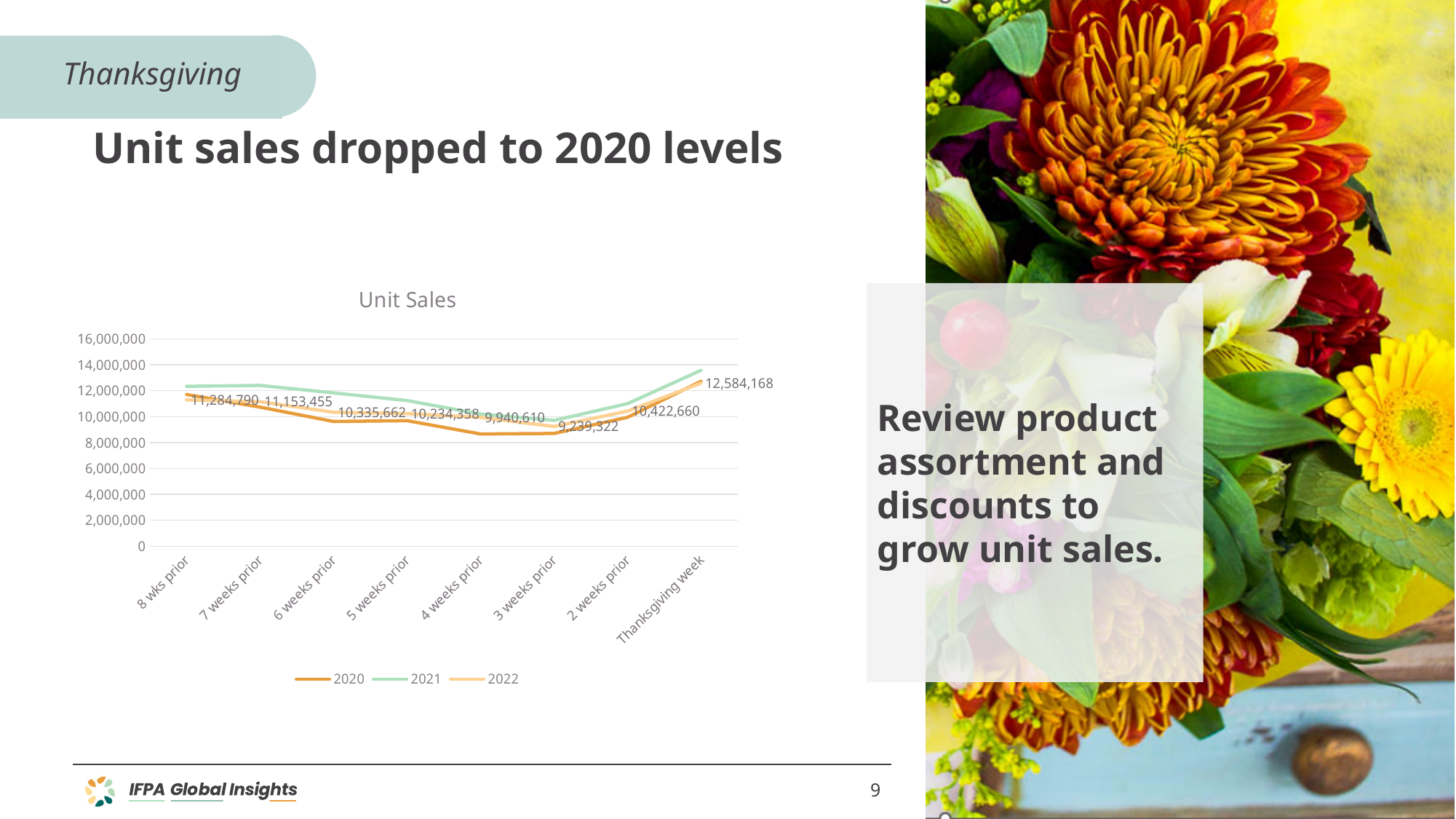
What is the 2022 unit sales value for 3 weeks prior? 9,239,322 What is the difference between the 2022 unit sales for Thanksgiving week and for 3 weeks prior? 3,344,846 In which period is the 2022 unit sales value highest? Thanksgiving week Is the 2020 unit sales value for 4 weeks prior greater or less than 10,000,000? less What is the 2022 unit sales value for Thanksgiving week? 12,584,168 How many time periods are plotted along the x axis of the Unit Sales chart? 8 What kind of chart is shown on the slide? line chart What is the title of the chart? Unit Sales At 8 wks prior, which series has the higher unit sales, 2020 or 2021? 2021 What is the 2022 unit sales value for 6 weeks prior? 10,335,662 How many series does the legend of the Unit Sales chart list? 3 In which period is the 2022 unit sales value lowest? 3 weeks prior